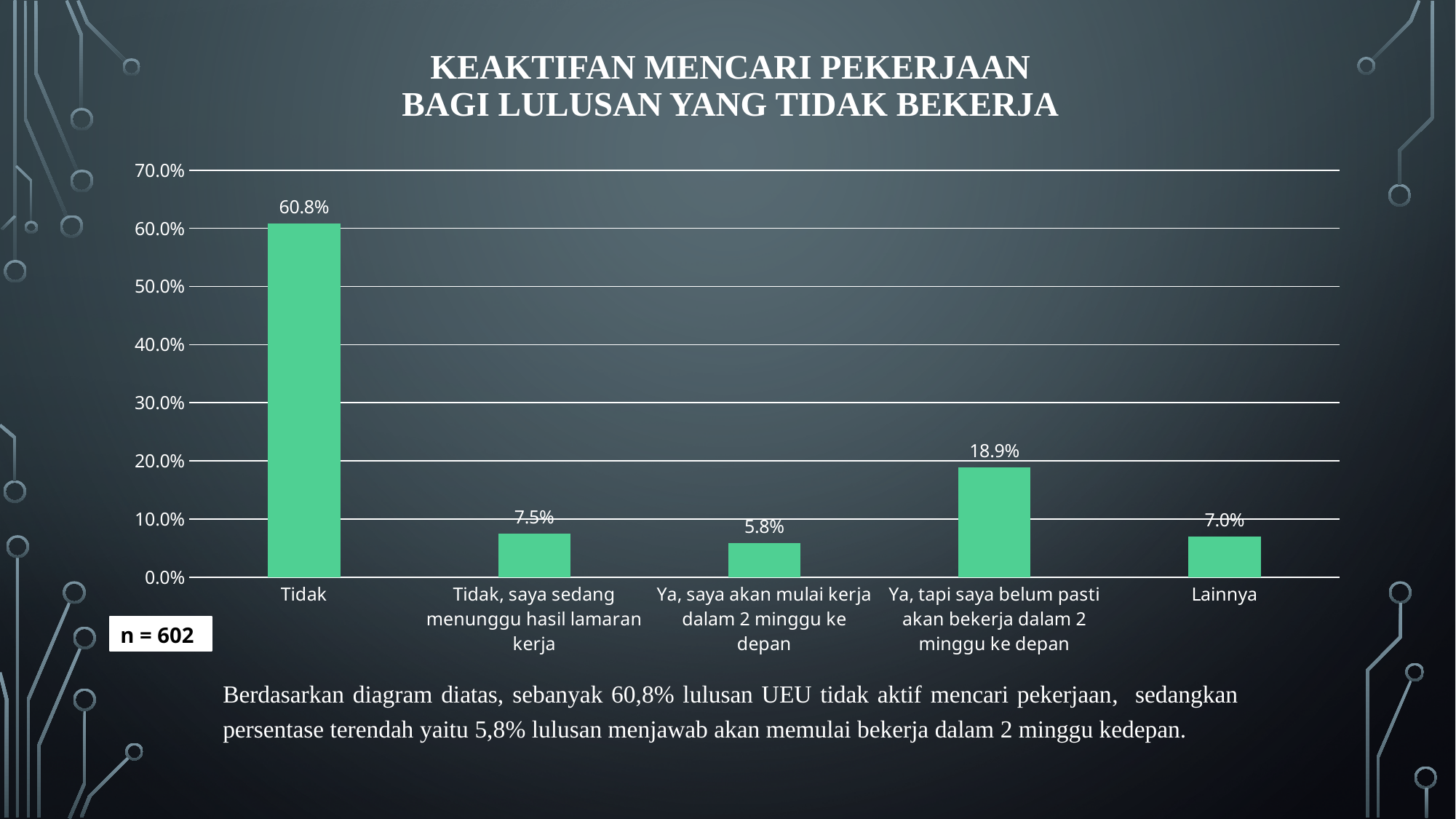
How many categories are shown on the x axis? 5 Which is larger, the value for "Tidak, saya sedang menunggu hasil lamaran kerja" or the value for "Lainnya"? Tidak, saya sedang menunggu hasil lamaran kerja What kind of chart is shown on the slide? bar chart What is the difference between the values for "Tidak" and "Ya, tapi saya belum pasti akan bekerja dalam 2 minggu ke depan"? 41.9% What sample size (n) is shown on the slide? n = 602 What is the value for "Tidak, saya sedang menunggu hasil lamaran kerja"? 7.5% Which category has the lowest value? Ya, saya akan mulai kerja dalam 2 minggu ke depan Is the value for "Ya, tapi saya belum pasti akan bekerja dalam 2 minggu ke depan" greater or less than 20.0%? less What is the value for "Tidak"? 60.8% What is the value for "Lainnya"? 7.0% Which category has the highest value? Tidak What is the value for "Ya, tapi saya belum pasti akan bekerja dalam 2 minggu ke depan"? 18.9%